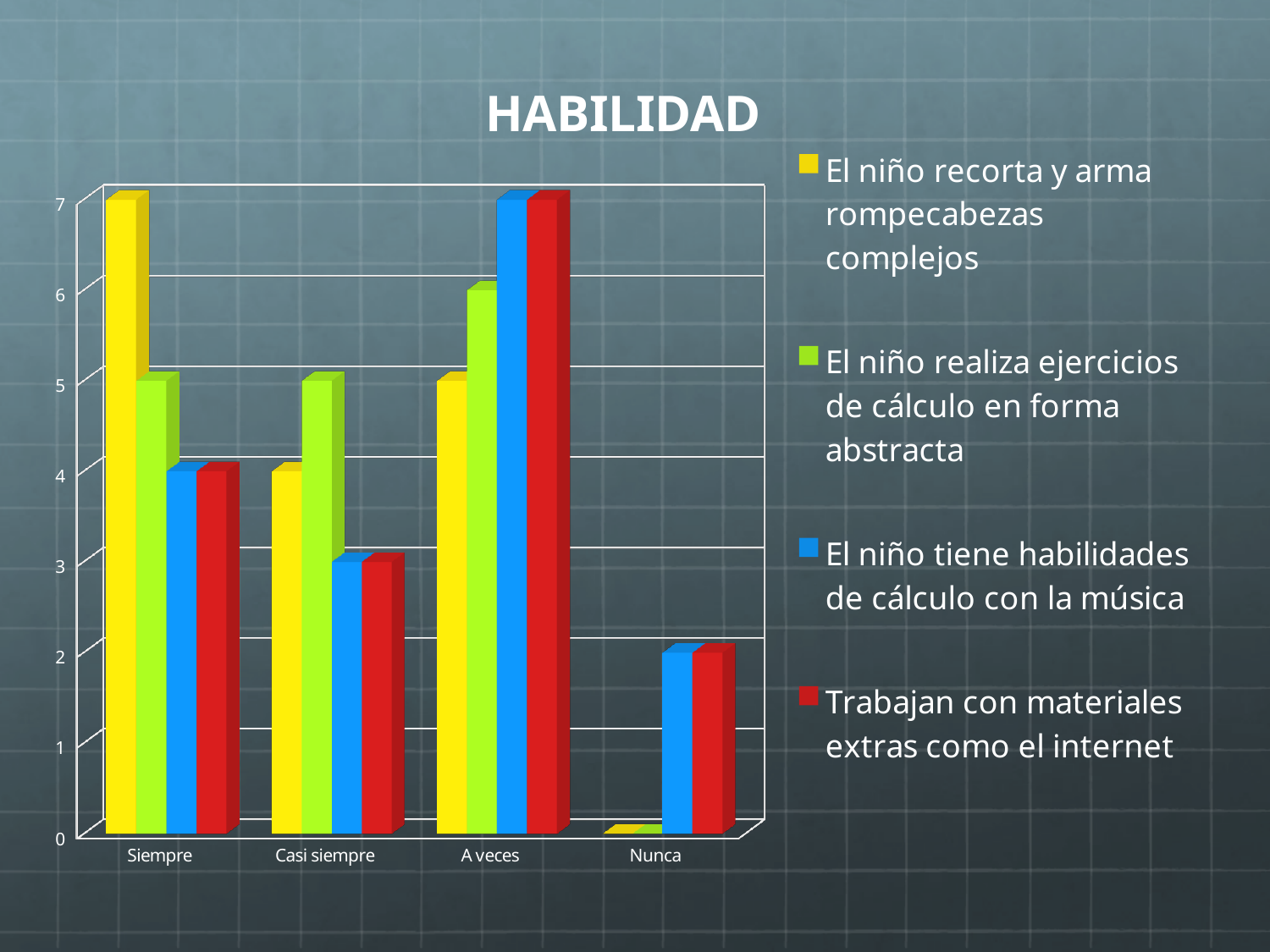
What is the value for 'Trabajan con materiales extras como el internet' in the Nunca category? 2 What kind of chart is shown on the slide? bar chart Which colour represents 'Trabajan con materiales extras como el internet' in the legend? red Which category has the highest value for 'El niño recorta y arma rompecabezas complejos'? Siempre What is the value for 'El niño tiene habilidades de cálculo con la música' in the A veces category? 7 Is the value for 'El niño realiza ejercicios de cálculo en forma abstracta' in the A veces category greater or less than 4? greater Which category has the lowest value for 'El niño tiene habilidades de cálculo con la música'? Nunca In the Casi siempre category, which is larger: 'El niño realiza ejercicios de cálculo en forma abstracta' or 'El niño tiene habilidades de cálculo con la música'? El niño realiza ejercicios de cálculo en forma abstracta How many series does the legend list? 4 What is the title of the chart? HABILIDAD What is the value for 'El niño recorta y arma rompecabezas complejos' in the Siempre category? 7 How many categories are shown on the x axis of the chart? 4